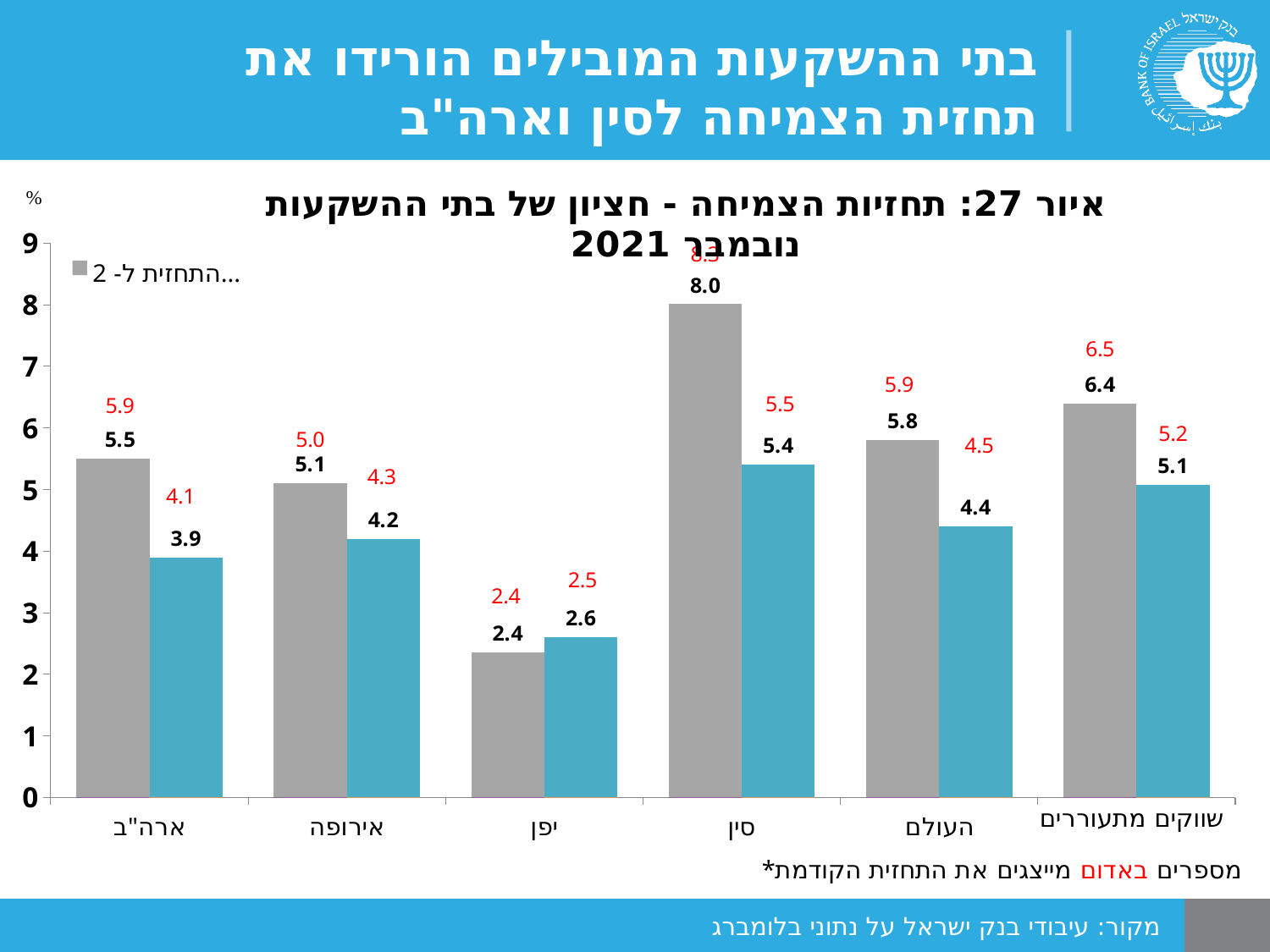
What is the value of the blue bar for ארה"ב? 3.9 What type of chart is shown on the slide? bar chart Which category has the lowest blue bar? יפן Which category has the highest gray bar? סין What is the value of the blue bar for יפן? 2.6 Which is larger for העולם, the gray bar or the blue bar? the gray bar How many categories are shown on the x axis of the chart? 6 Is the value of the gray bar for אירופה greater or less than 4? greater What is the value of the gray bar for שווקים מתעוררים? 6.4 What is the difference between the gray bar and the blue bar for סין? 2.6 What is the value of the gray bar for סין? 8.0 What red number is printed above the blue bar for העולם? 4.5